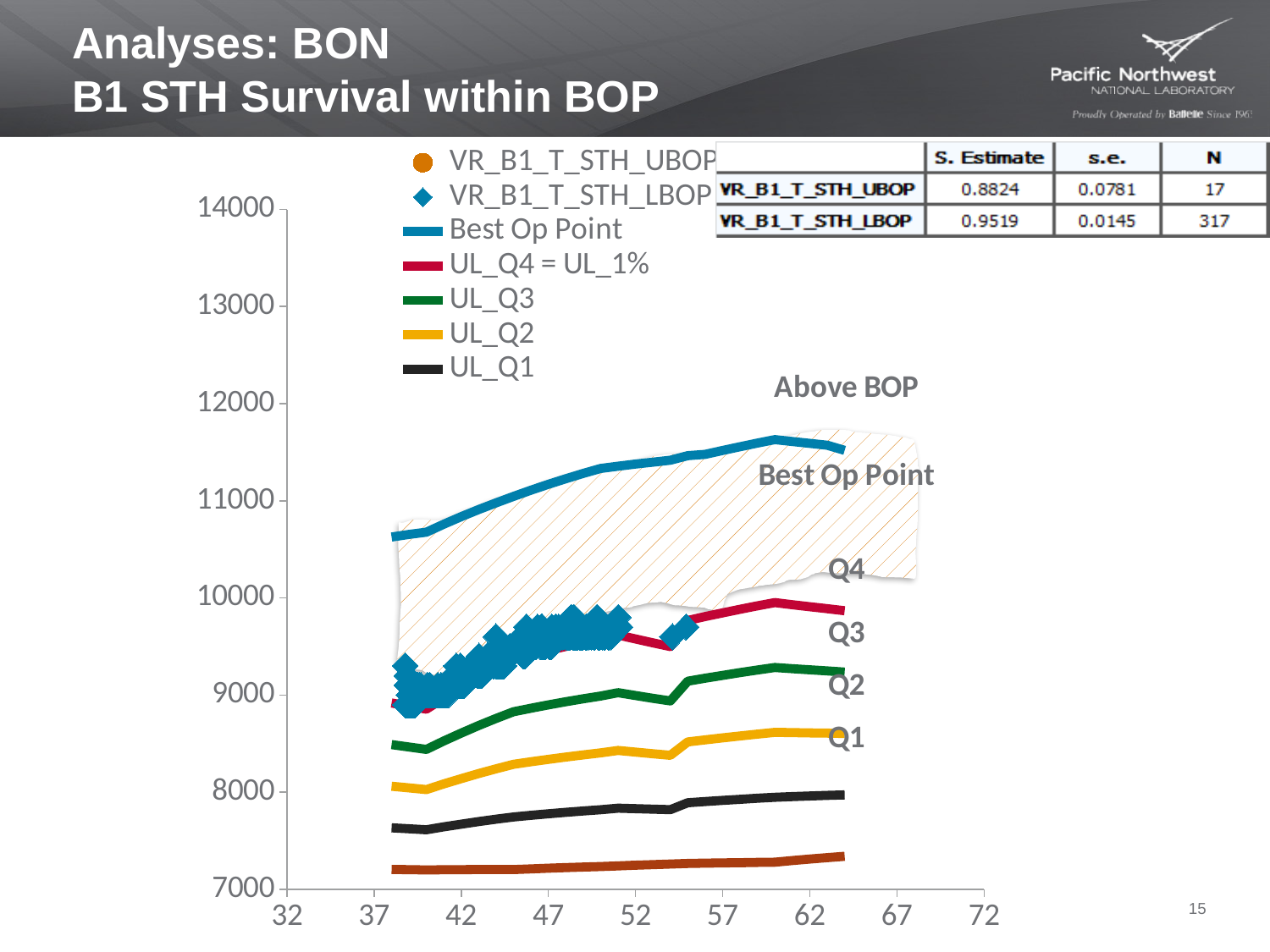
What kind of chart is shown on the slide? line chart Is the value of the UL_Q2 line at x = 62 greater or less than 8000? greater Which series is plotted highest on the chart? Best Op Point Is the value of the UL_Q4 = UL_1% line at x = 62 greater or less than 10000? less How many series does the chart legend list? 7 Does the Best Op Point line rise or fall as x increases from 38 to 62? rise What is the highest value shown on the vertical axis? 14000 Which is plotted higher at x = 62, the Best Op Point line or the UL_Q3 line? Best Op Point Is the value of the Best Op Point line at x = 62 greater or less than 11000? greater What marker symbol does the legend use for VR_B1_T_STH_LBOP? blue diamond